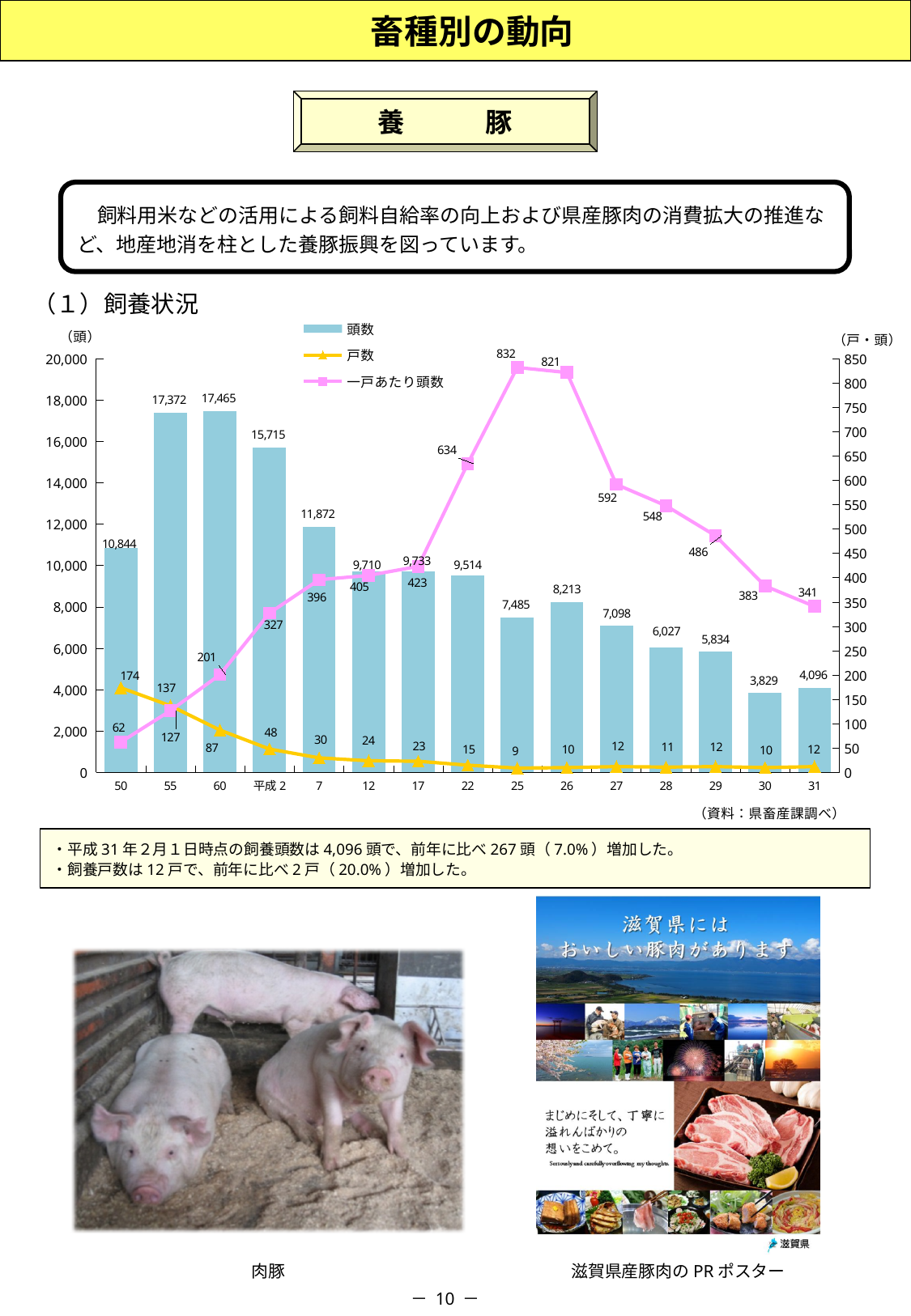
How many years are shown on the x axis? 15 What is the difference in 頭数 between 30 and 31? 267 Does the 戸数 line rise or fall from 50 to 22? fall What is the 頭数 value for 平成 31? 4,096 What is the 一戸あたり頭数 value for 25? 832 Which year has the lowest 頭数? 30 What is the 戸数 value for 50? 174 Which year has the highest 頭数? 60 How many series does the legend list? 3 What kind of chart is used for 頭数? bar chart Which is larger, the 頭数 for 55 or for 60? 60 Which year has the highest 一戸あたり頭数? 25